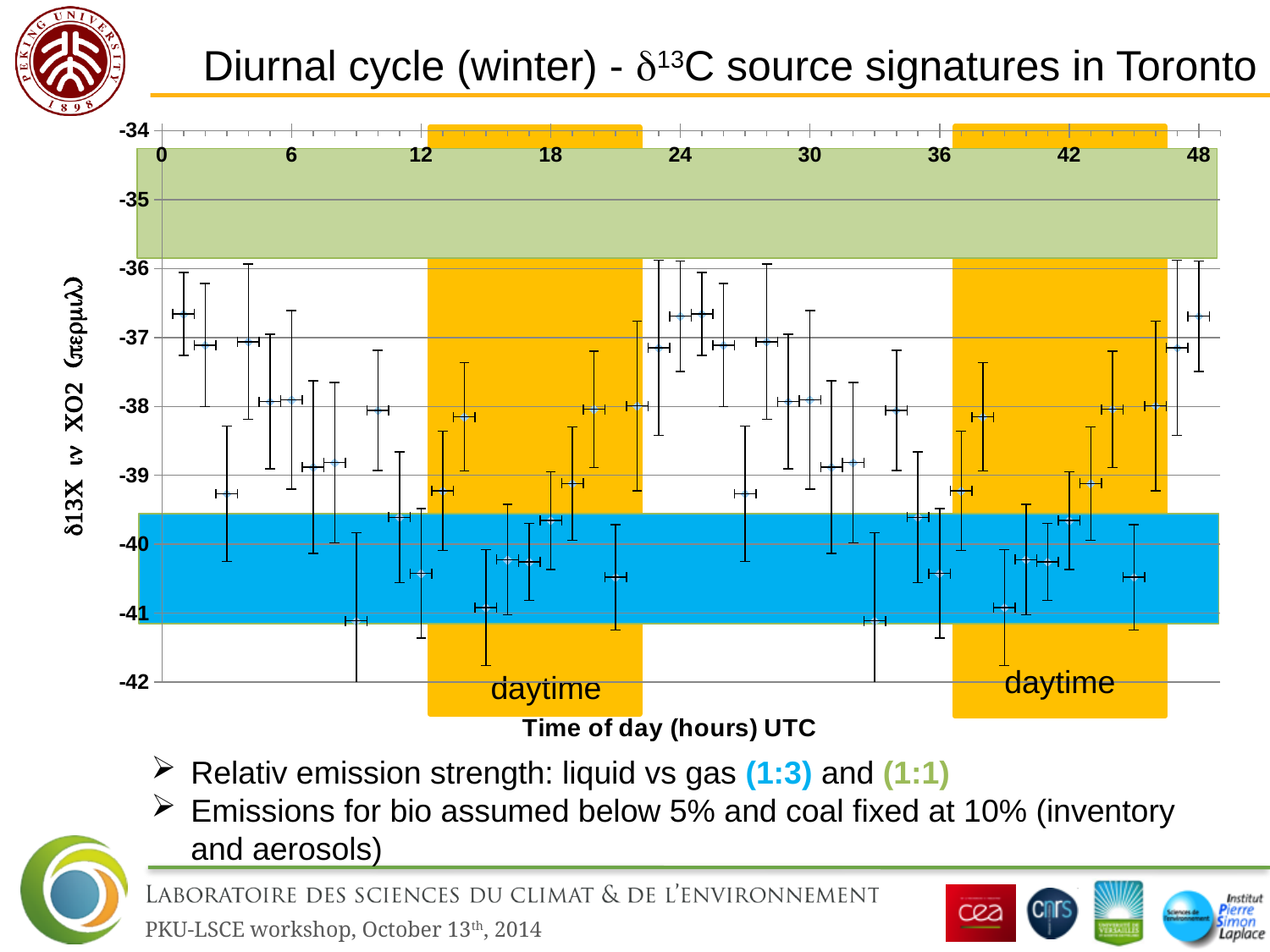
What label is written inside the two orange shaded bands on the chart? daytime Which is larger, the value plotted at hour 24 or the value plotted at hour 18? hour 24 Is the value plotted at hour 48 greater or less than -39? greater Do the plotted values generally rise or fall between hour 18 and hour 24? rise What is the title of the x axis of the chart? Time of day (hours) UTC Is the value plotted at hour 42 greater or less than -38? less Is the value plotted at hour 24 greater or less than -38? greater What kind of chart is shown on the slide? Scatter plot with error bars